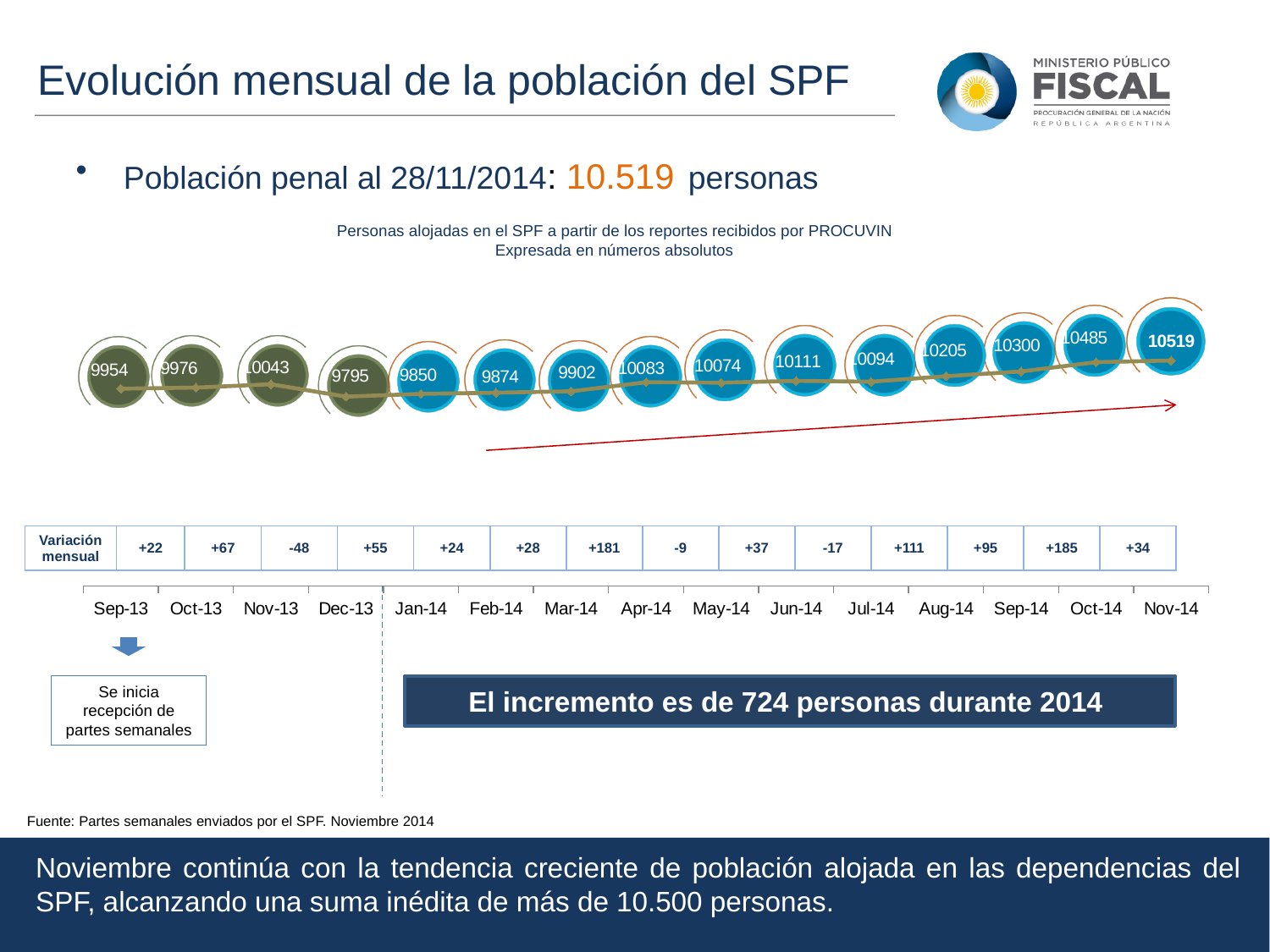
What kind of chart is used to show the monthly population? line chart Which month has the lowest plotted population value? Dec-13 What monthly variation is shown in the table for Mar-14? +181 What is the difference between the values for Nov-14 and Oct-14? 34 What is the population value plotted for Nov-14? 10519 Overall, do the plotted values rise or fall from Sep-13 to Nov-14? rise What is the population value plotted for Mar-14? 9902 Which is larger, the value for Apr-14 or the value for May-14? Apr-14 What is the population value plotted for Dec-13? 9795 How many monthly data points are plotted on the chart? 15 What is the difference between the values for Sep-14 and Aug-14? 95 Which month has the highest plotted population value? Nov-14